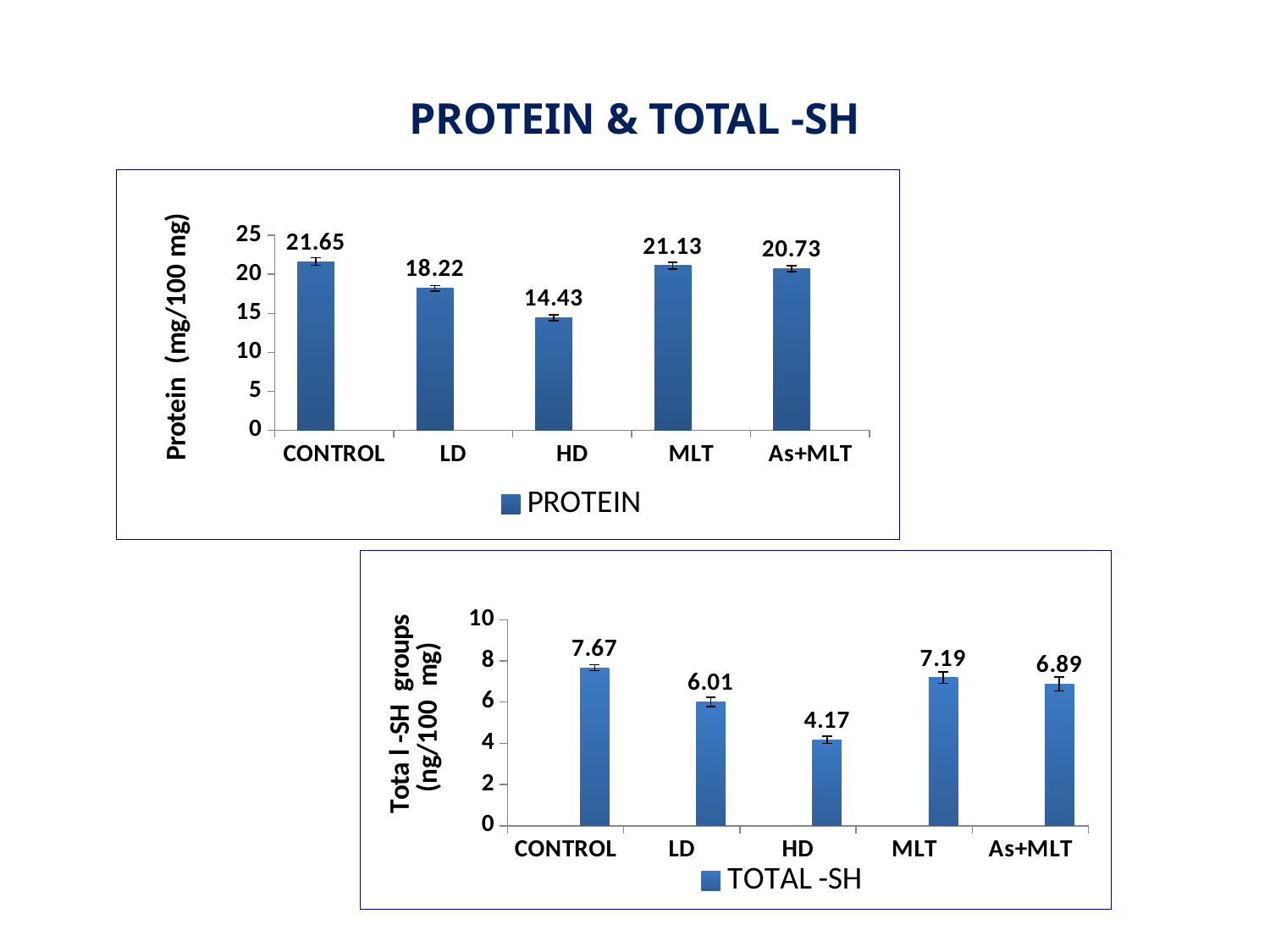
In the TOTAL -SH chart (bottom), which is larger, the value for CONTROL or the value for As+MLT? CONTROL What kind of chart is the TOTAL -SH chart (bottom)? Bar chart In the PROTEIN chart (top), what is the difference between the CONTROL and LD values? 3.43 In the TOTAL -SH chart (bottom), what is the value for MLT? 7.19 In the PROTEIN chart (top), which category has the highest value? CONTROL In the TOTAL -SH chart (bottom), which category has the lowest value? HD In the TOTAL -SH chart (bottom), what is the value for LD? 6.01 In the PROTEIN chart (top), what is the value for HD? 14.43 In the PROTEIN chart (top), how many categories are shown on the x axis? 5 In the PROTEIN chart (top), which category has the lowest value? HD In the PROTEIN chart (top), what is the value for As+MLT? 20.73 In the TOTAL -SH chart (bottom), what is the difference between the CONTROL and HD values? 3.50